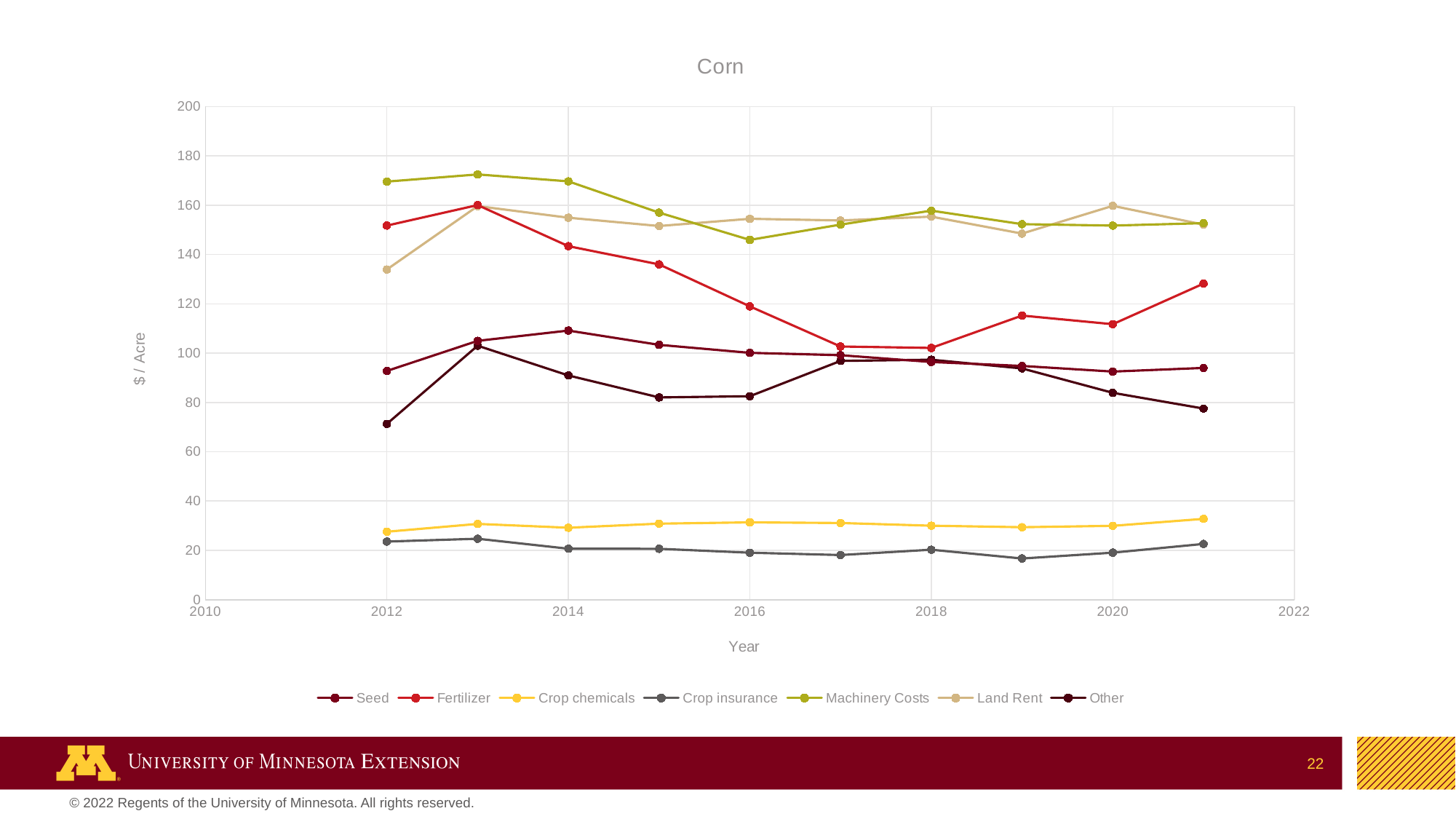
Is the value for Machinery Costs in 2013 greater or less than 160? greater What is the title of the chart? Corn What kind of chart is shown on the slide? line chart How many yearly data points are plotted for each series? 10 What is the label on the vertical axis? $ / Acre Which series has the highest value in 2013? Machinery Costs Does the Fertilizer line rise or fall from 2013 to 2017? fall Is the value for Fertilizer in 2021 greater or less than 120? greater Is the value for Crop insurance in 2019 greater or less than 20? less Which series has the lowest values across all years? Crop insurance How many series does the legend list? 7